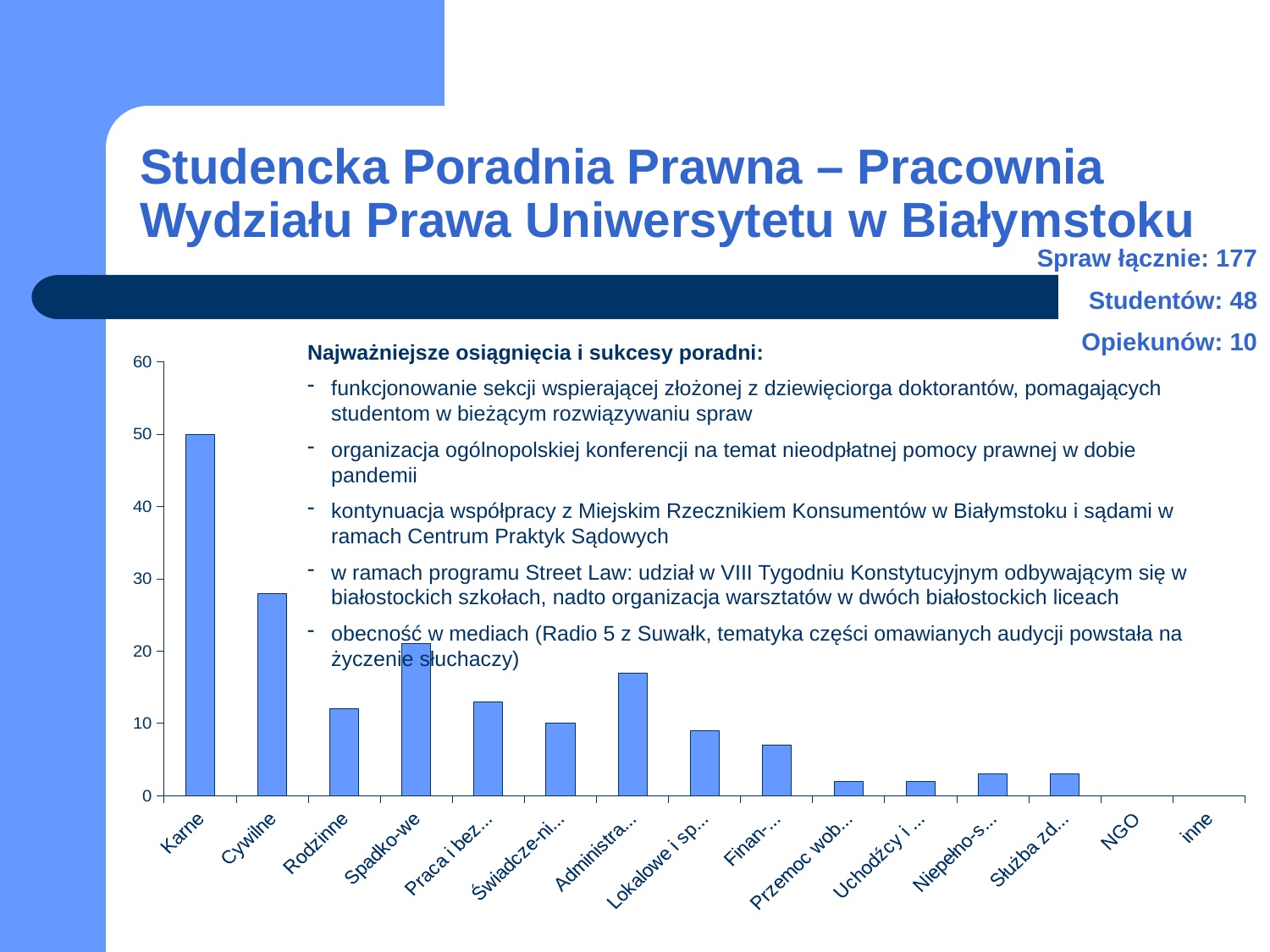
Is the value for Finan-... greater or less than 10? less Which is larger, the value for Cywilne or the value for Spadko-we? Cywilne Which category has the highest bar in the chart? Karne What colour are the bars in the chart? blue Which is larger, the value for Karne or the value for Cywilne? Karne Is the value for Administra... greater or less than 20? less Which is larger, the value for Administra... or the value for Rodzinne? Administra... Is the value for Cywilne greater or less than 20? greater What kind of chart is shown on the slide? bar chart What is the value for Karne in the chart? 50 How many categories are shown on the x axis of the chart? 15